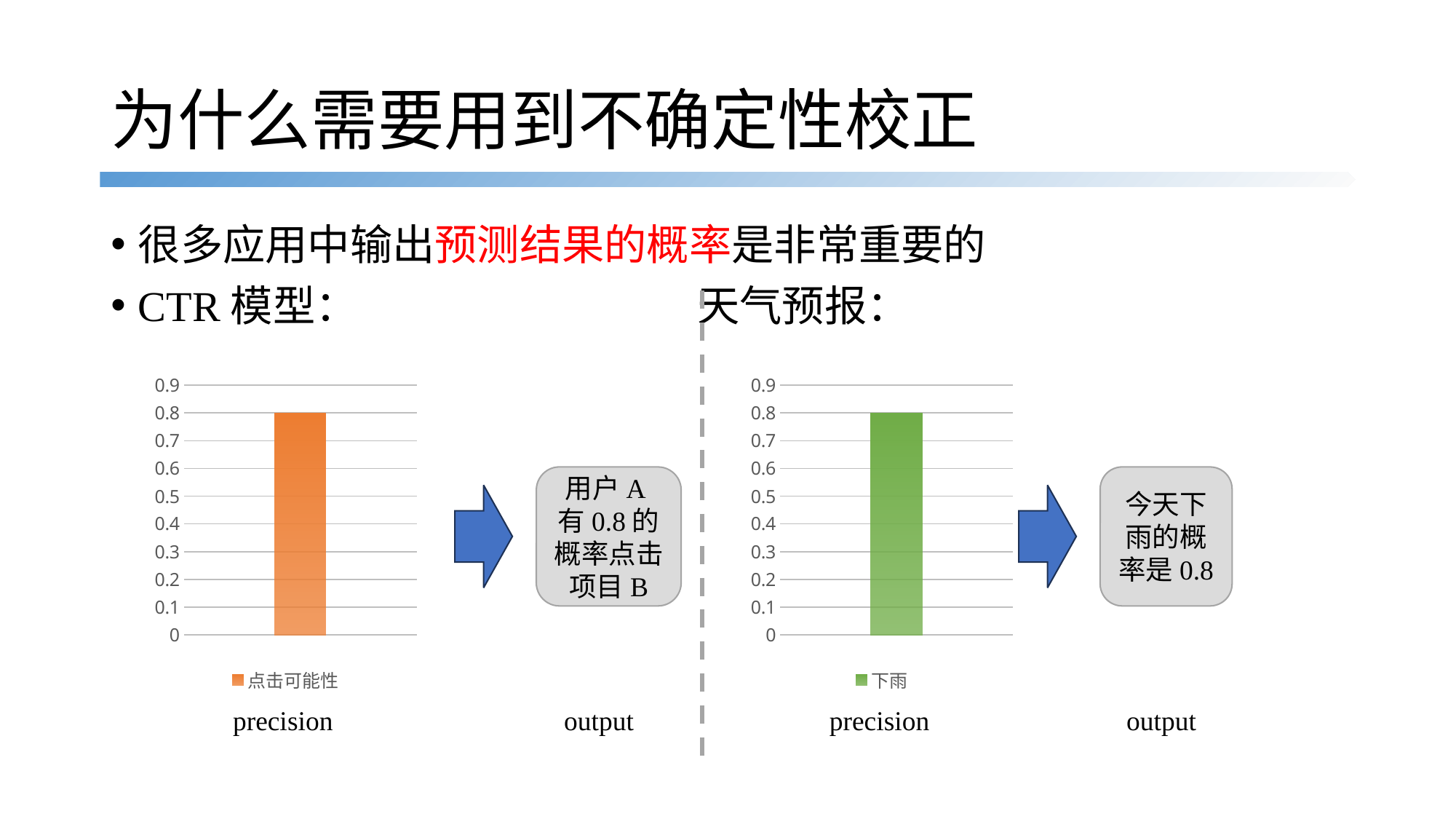
What colour is the bar in the right chart under "天气预报"? green What is the legend entry of the left chart under "CTR 模型"? 点击可能性 What kind of chart is the right chart under "天气预报"? bar chart How many series does the legend of the left chart under "CTR 模型" list? 1 How many bars are plotted in the right chart under "天气预报"? 1 How many bars are plotted in the left chart under "CTR 模型"? 1 In the right chart under "天气预报", is the value for 下雨 greater or less than 0.9? less What kind of chart is the left chart under "CTR 模型"? bar chart In the left chart under "CTR 模型", is the value for 点击可能性 greater or less than 0.5? greater In the left chart under "CTR 模型", what value does the bar for 点击可能性 reach? 0.8 How many series does the legend of the right chart under "天气预报" list? 1 In the right chart under "天气预报", what value does the bar for 下雨 reach? 0.8